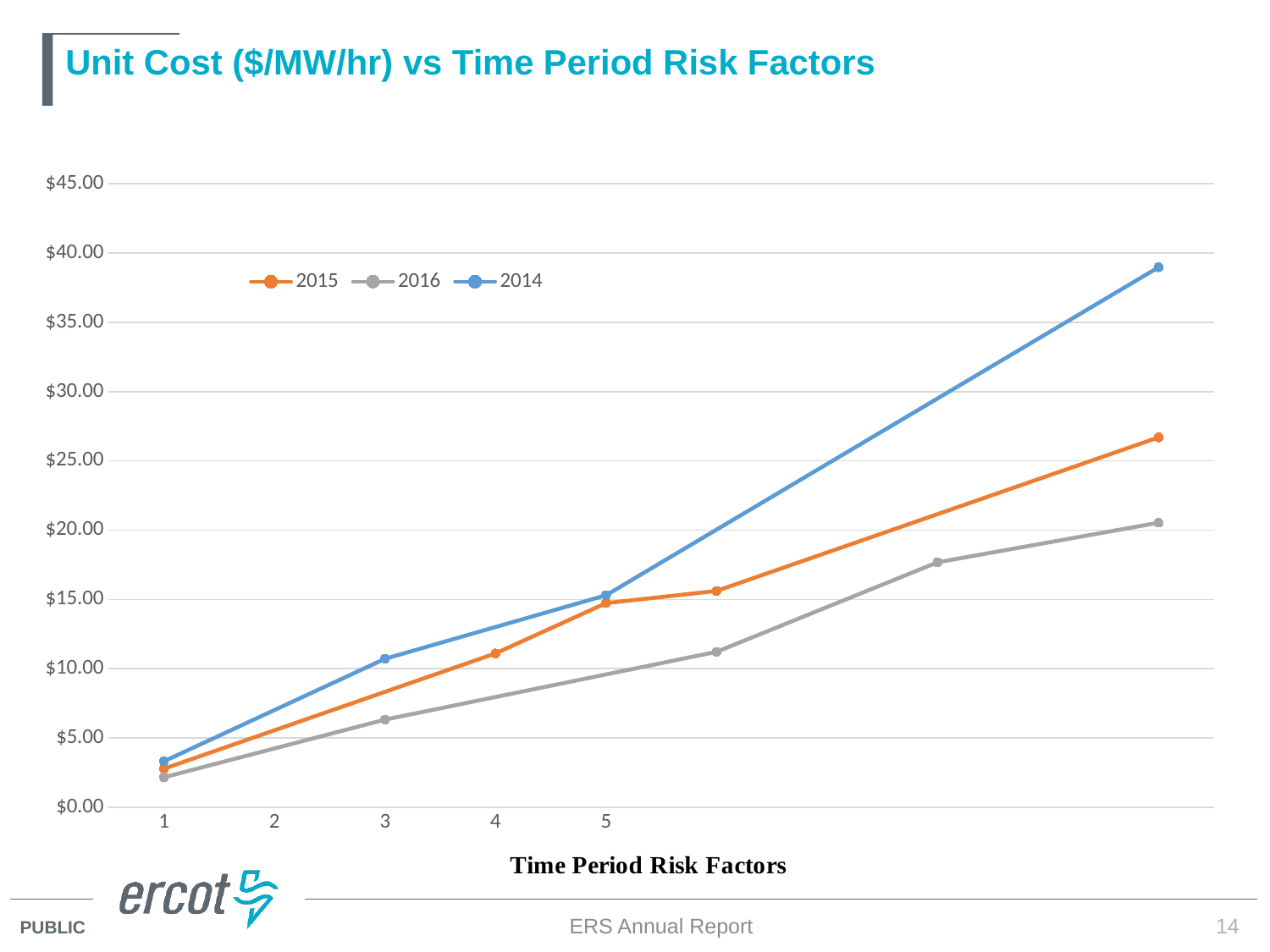
Do the unit cost values for 2014 rise or fall as the time period risk factor increases? rise What is the title of the x axis? Time Period Risk Factors At time period risk factor 1, which series has the larger unit cost, 2014 or 2016? 2014 Is the 2016 unit cost at time period risk factor 3 greater or less than $10.00? less Is the 2016 unit cost at time period risk factor 1 greater or less than $5.00? less Which series has the lowest unit cost at time period risk factor 3? 2016 How many series does the legend list? 3 Is the 2015 unit cost at time period risk factor 4 greater or less than $10.00? greater Which series is drawn in orange? 2015 Which series has the highest unit cost at time period risk factor 3? 2014 What kind of chart is shown on the slide? line chart